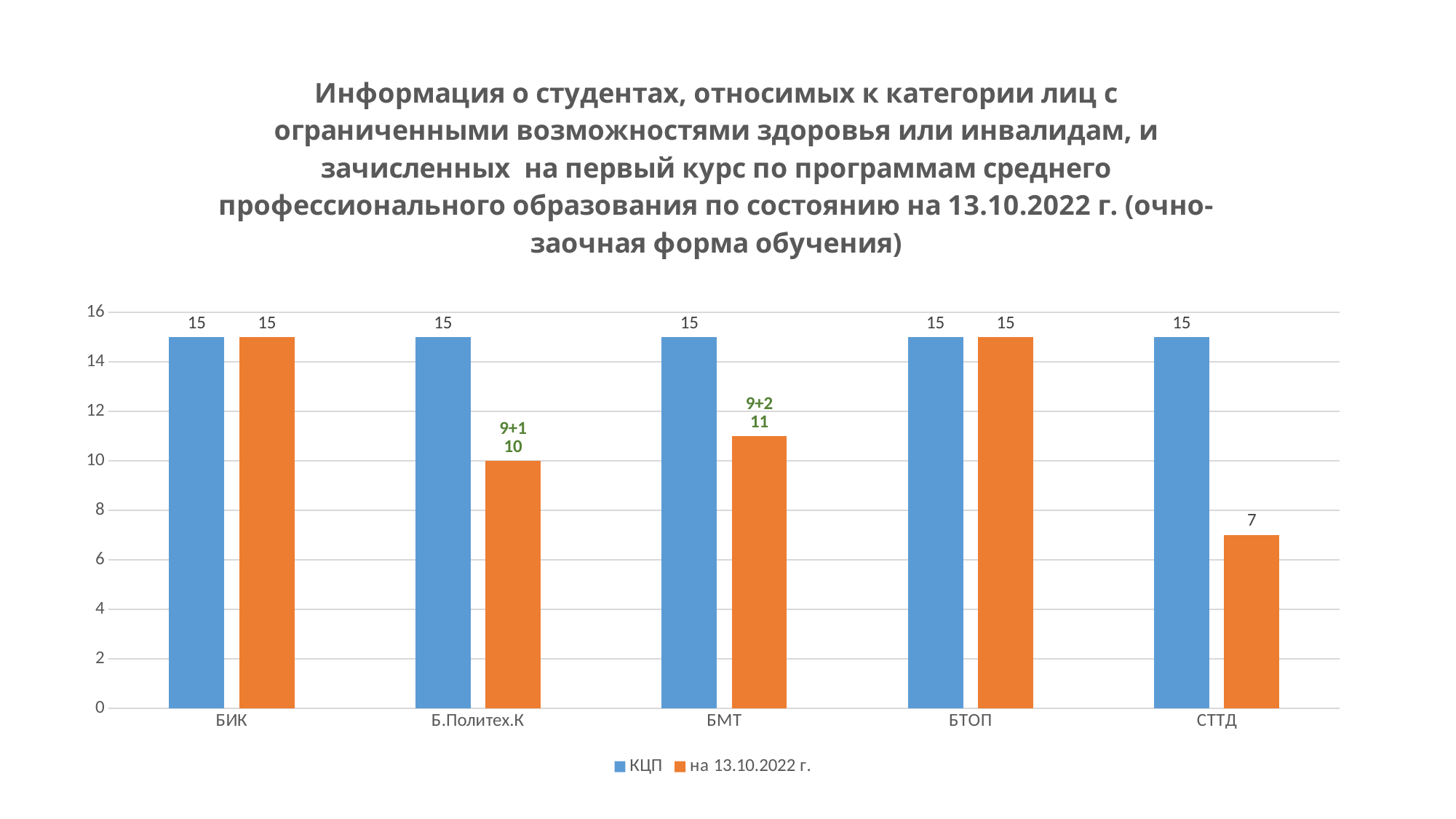
Which colour represents the КЦП series in the legend? Blue What is the КЦП value for БТОП? 15 Which is larger for Б.Политех.К: the КЦП value or the 'на 13.10.2022 г.' value? КЦП What is the value of the 'на 13.10.2022 г.' series for Б.Политех.К? 10 What is the value of the 'на 13.10.2022 г.' series for СТТД? 7 How many series does the legend list? 2 What is the difference between the КЦП value and the 'на 13.10.2022 г.' value for БМТ? 4 What is the value of the 'на 13.10.2022 г.' series for БМТ? 11 Which category has the lowest value in the 'на 13.10.2022 г.' series? СТТД How many categories are shown on the x axis? 5 What is the difference between the КЦП value and the 'на 13.10.2022 г.' value for СТТД? 8 What kind of chart is shown on the slide? Bar chart